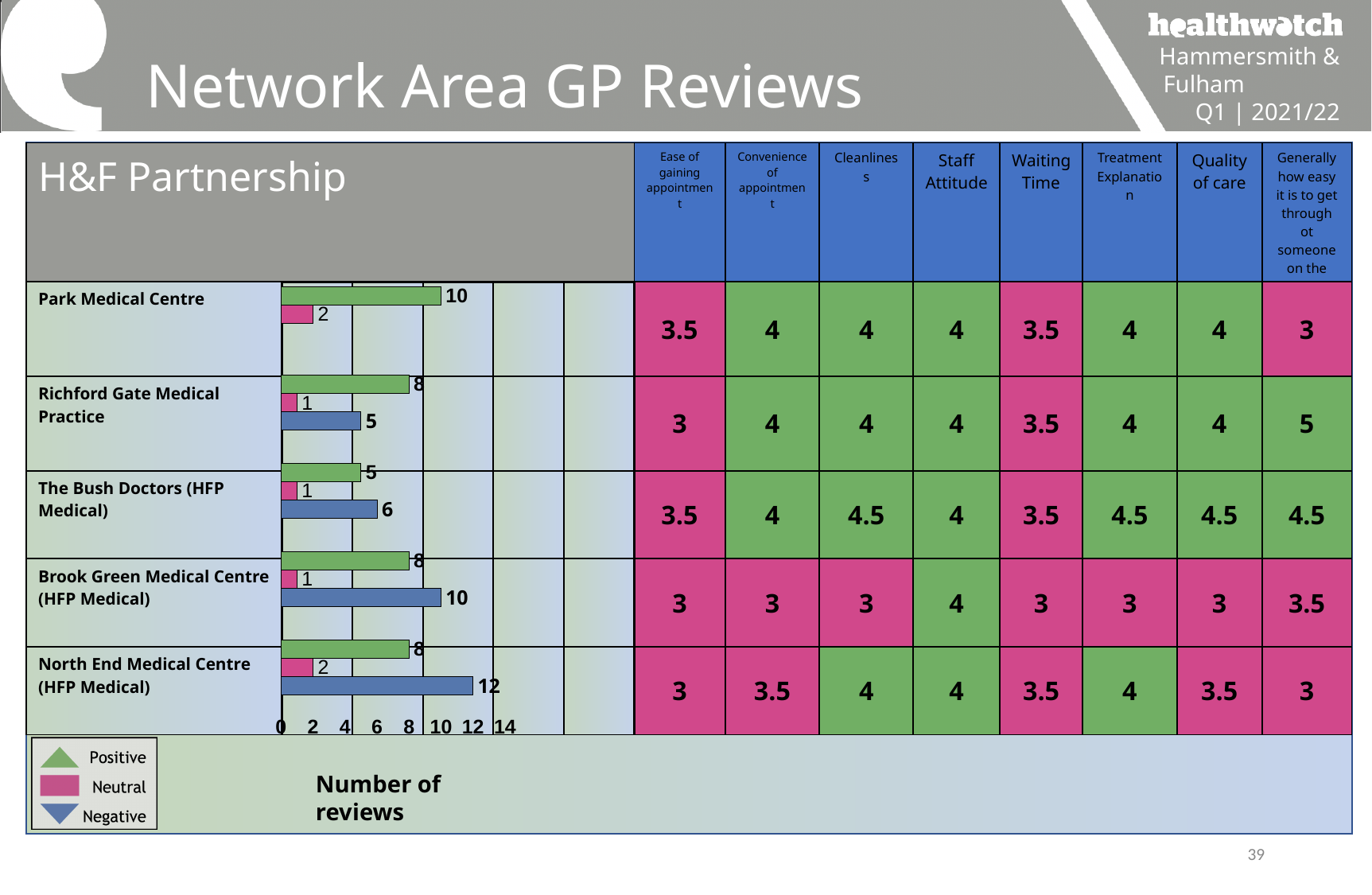
How many positive reviews does Park Medical Centre have? 10 How many neutral reviews does Richford Gate Medical Practice have? 1 How many series does the legend of the number of reviews chart list? 3 What is the difference between the negative and positive reviews for Brook Green Medical Centre (HFP Medical)? 2 How many negative reviews does North End Medical Centre (HFP Medical) have? 12 How many GP practices are shown in the number of reviews chart? 5 How many negative reviews does The Bush Doctors (HFP Medical) have? 6 Which is larger for Richford Gate Medical Practice: positive reviews or negative reviews? positive reviews Which colour represents Neutral reviews in the chart legend? pink Which practice has the most negative reviews? North End Medical Centre (HFP Medical) Which practice has the fewest positive reviews? The Bush Doctors (HFP Medical) What kind of chart is used to show the number of reviews on the slide? bar chart